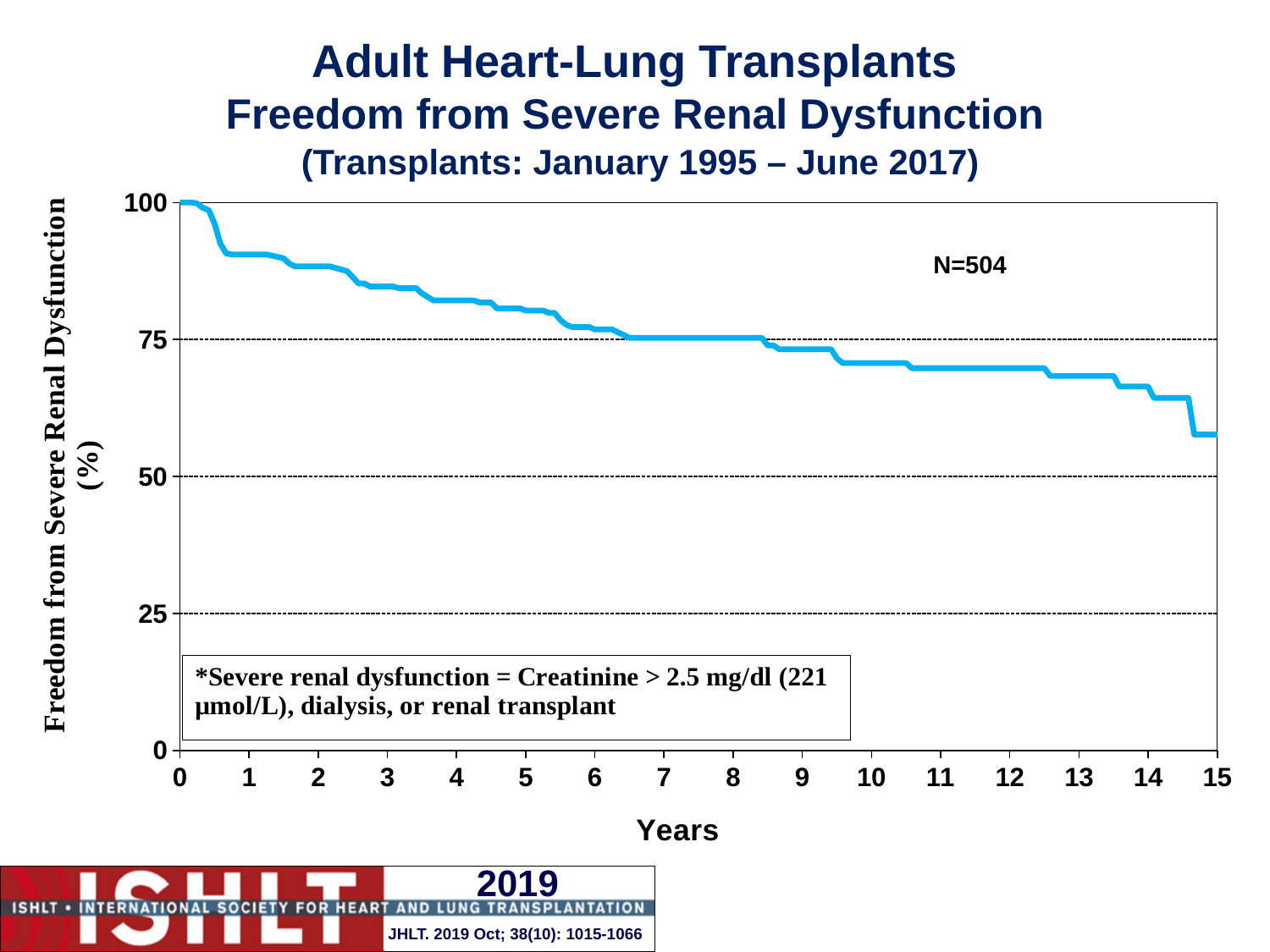
Which is larger, the value at year 2 or the value at year 12? year 2 Is the value for freedom from severe renal dysfunction at year 10 greater or less than 75? less Does the freedom from severe renal dysfunction curve rise or fall as years increase? fall Is the value for freedom from severe renal dysfunction at year 15 greater or less than 50? greater What is the value of freedom from severe renal dysfunction at year 0? 100 How many year tick marks are labelled on the x axis? 16 Is the value for freedom from severe renal dysfunction at year 5 greater or less than 75? greater What is the sample size (N) shown on the chart? N=504 What kind of chart is shown on the slide? line chart What is the label of the x axis? Years